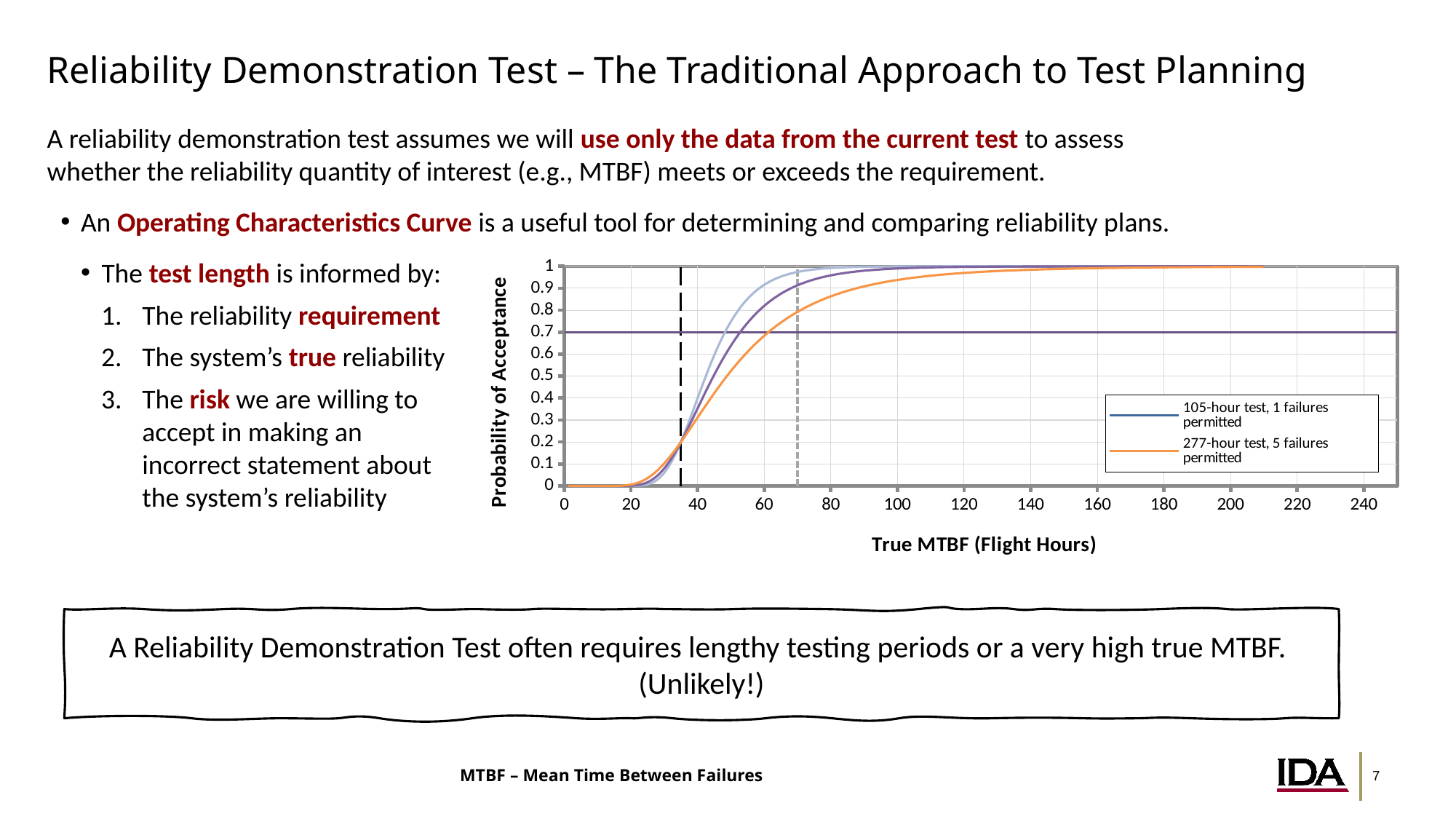
How many series does the chart's legend list? 2 What kind of chart is shown on the slide? line chart At a True MTBF of 80 flight hours, is the probability of acceptance for the 277-hour test, 5 failures permitted greater or less than 0.7? greater At a True MTBF of 40 flight hours, is the probability of acceptance for the 277-hour test, 5 failures permitted greater or less than 0.5? less Do the curves rise or fall as True MTBF increases along the x axis? rise At a True MTBF of 20 flight hours, is the probability of acceptance for the 105-hour test, 1 failures permitted greater or less than 0.1? less What is the label of the x axis of the chart? True MTBF (Flight Hours) What is the largest value shown on the x axis of the chart? 240 What is the label of the y axis of the chart? Probability of Acceptance